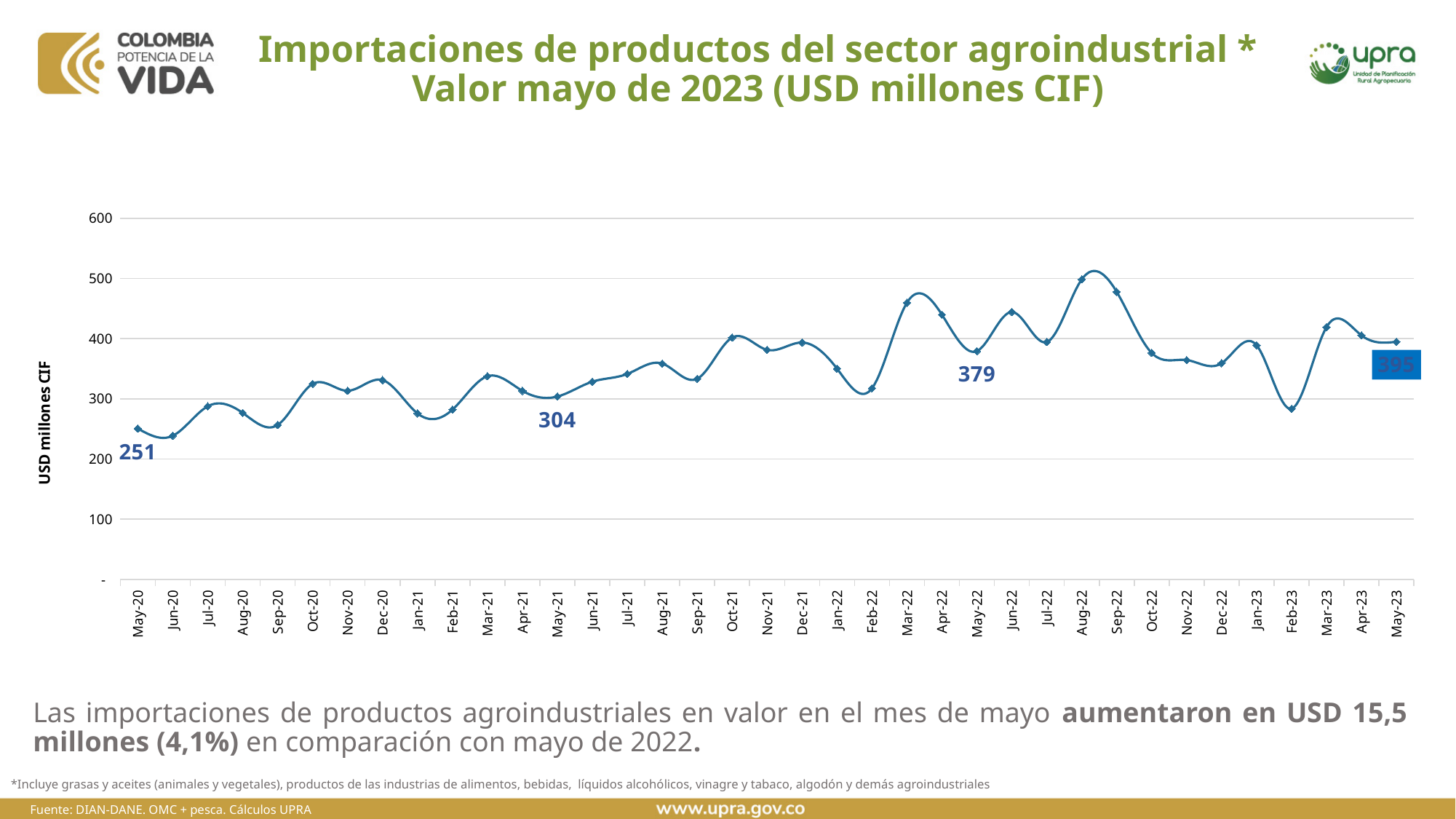
What is the difference between the values for May-22 and May-21? 75 Which month has the lowest value on the chart? Jun-20 What is the value for May-20? 251 What is the value for May-22? 379 Which month has the highest value on the chart? Aug-22 What is the difference between the values for May-23 and May-22? 16 Is the value for Mar-22 greater or less than 400? greater What is the value for May-23? 395 What kind of chart is shown on the slide? line chart What is the value for May-21? 304 What is the label of the vertical axis? USD millones CIF Is the value for Feb-23 greater or less than 300? less